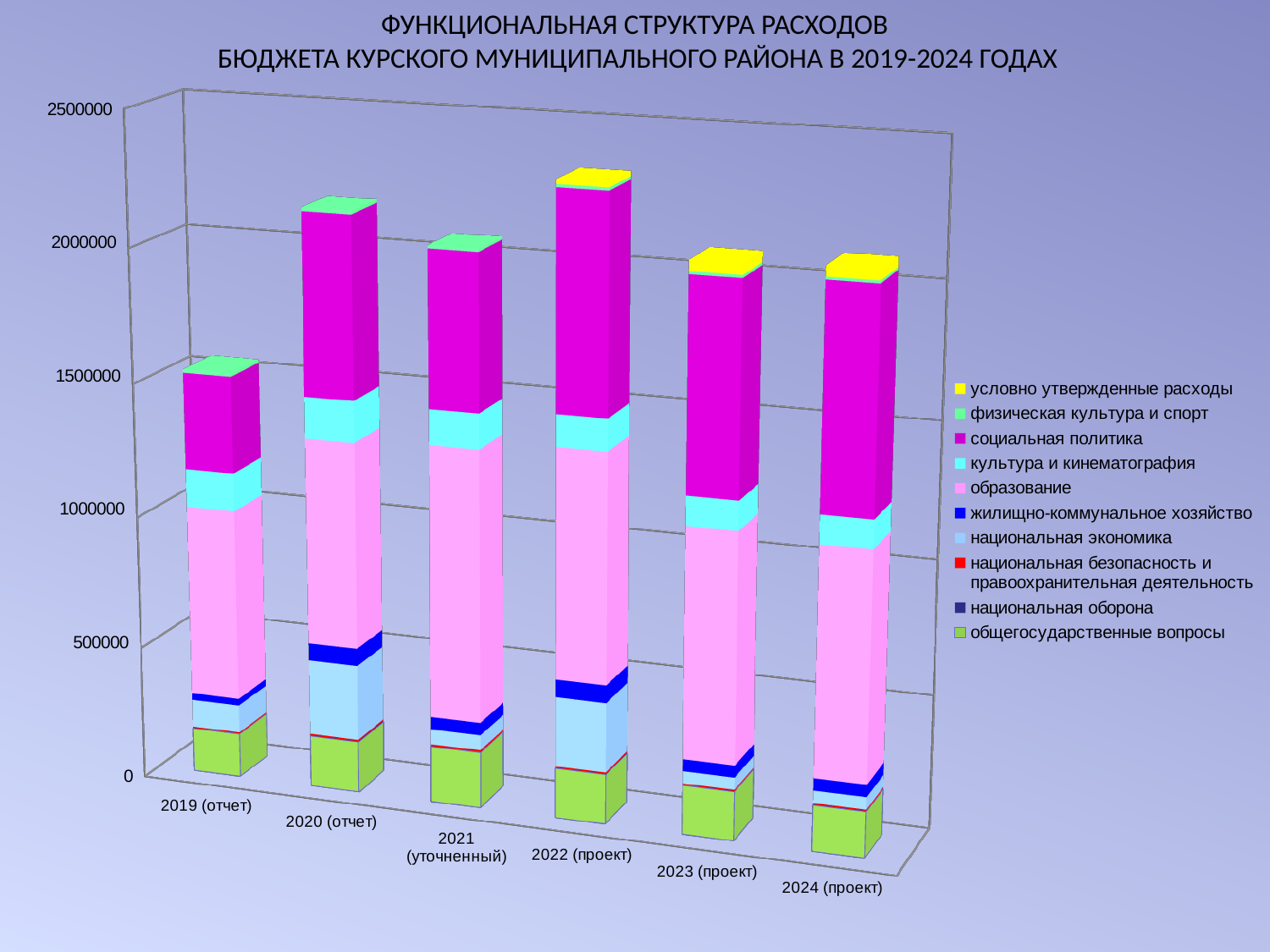
How many years (categories) are shown on the x axis? 6 Which series is listed first (at the top) in the legend? условно утвержденные расходы What kind of chart is shown on the slide? stacked bar chart What colour represents the series 'образование' in the chart? pink Which year has the shortest stacked bar (smallest total expenditure)? 2019 (отчет) Is the total for 2024 (проект) greater or less than 1000000? greater Is the total for 2022 (проект) greater or less than 2000000? greater Which total is larger, 2020 (отчет) or 2021 (уточненный)? 2020 (отчет) Which total is larger, 2019 (отчет) or 2022 (проект)? 2022 (проект) How many series does the legend list? 10 Which year has the tallest stacked bar (largest total expenditure)? 2022 (проект) Is the total for 2019 (отчет) greater or less than 2000000? less